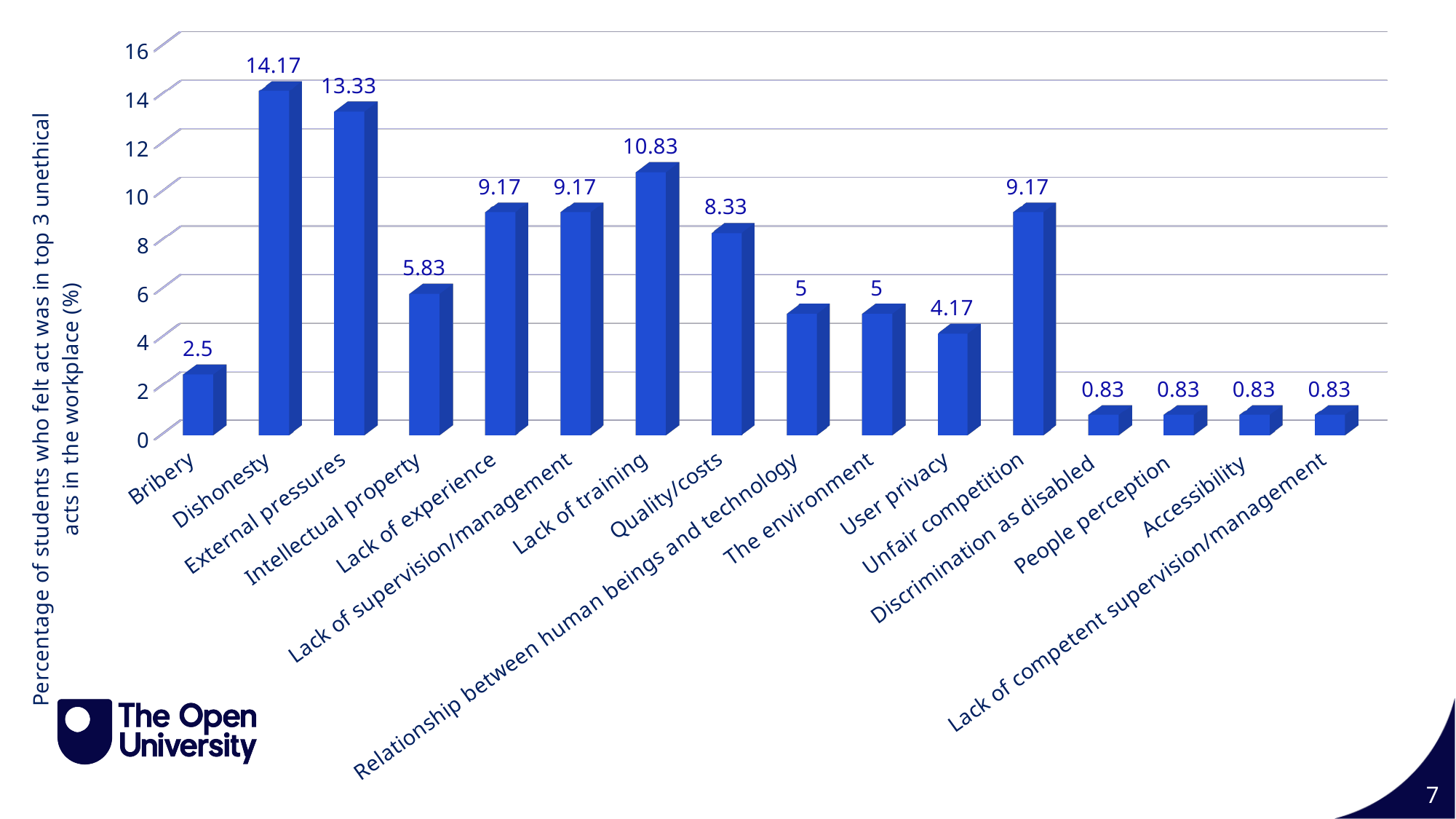
What is the value for User privacy? 4.17 What is the difference between the values for Lack of training and Quality/costs? 2.5 Which category has the highest value? Dishonesty What is the difference between the values for Dishonesty and External pressures? 0.84 How many categories are shown on the x axis? 16 What is the value for Dishonesty? 14.17 What is the value for Accessibility? 0.83 What is the value for Lack of training? 10.83 Which is larger, the value for Intellectual property or the value for Bribery? Intellectual property What kind of chart is shown on the slide? bar chart Is the value for External pressures greater or less than 12? greater What is the label of the vertical axis? Percentage of students who felt act was in top 3 unethical acts in the workplace (%)